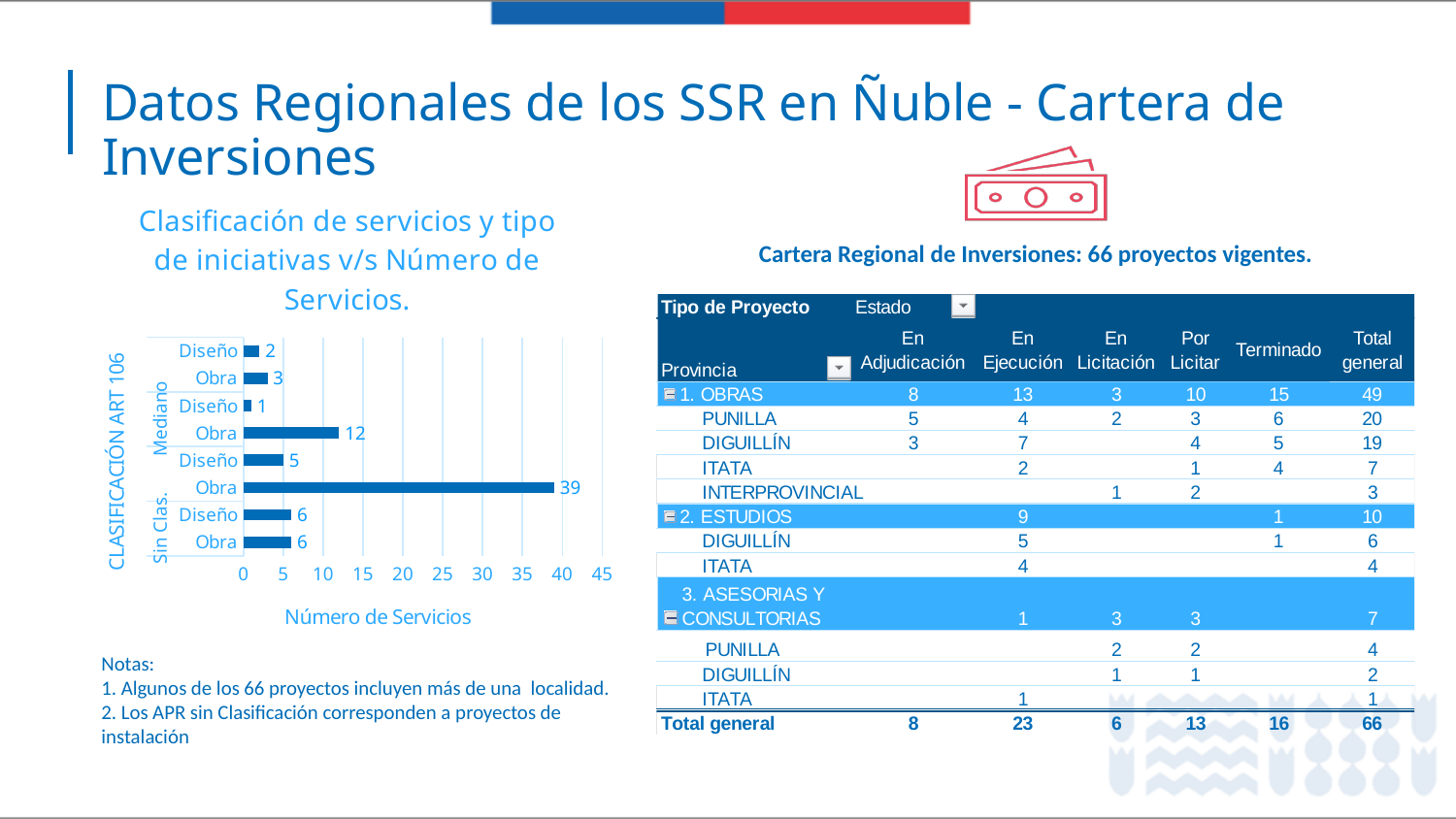
What is the value for Obra in the Mediano group? 12 What kind of chart is shown on the slide? bar chart What is the difference between Obra and Diseño in the Mediano group? 11 Which is larger in the Mediano group, Obra or Diseño? Obra What is the x-axis title of the bar chart? Número de Servicios What is the value for Diseño in the Mediano group? 1 What is the value of the topmost bar (Diseño) in the chart? 2 Is the value of the longest Obra bar greater or less than 35? greater How many bars are plotted in the bar chart? 8 What is the value of the longest bar in the chart? 39 What is the value for Obra in the Sin Clas. group? 6 What is the highest tick value shown on the x axis of the chart? 45